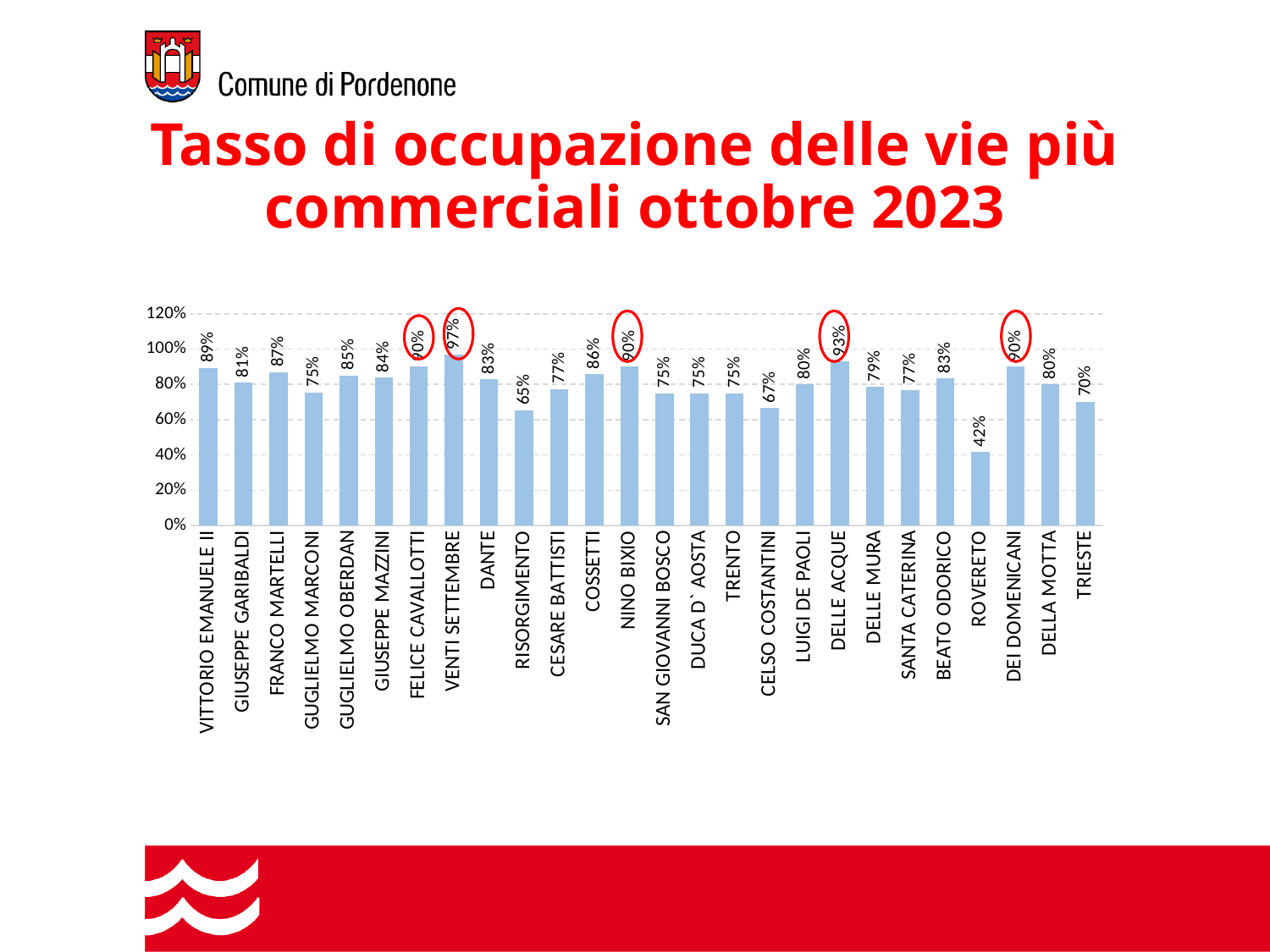
Which street has the lowest occupancy rate? ROVERETO What is the occupancy rate shown for VENTI SETTEMBRE? 97% What is the value shown for ROVERETO? 42% What kind of chart is shown on the slide? bar chart Which street has the highest occupancy rate? VENTI SETTEMBRE What is the title of the slide? Tasso di occupazione delle vie più commerciali ottobre 2023 How many streets are shown on the chart? 26 Which has a higher value, FRANCO MARTELLI or GIUSEPPE GARIBALDI? FRANCO MARTELLI What is the value shown for RISORGIMENTO? 65% What is the value shown for DELLE ACQUE? 93% What is the difference between the values for VENTI SETTEMBRE and ROVERETO? 55% Is the value for CELSO COSTANTINI greater or less than 80%? less